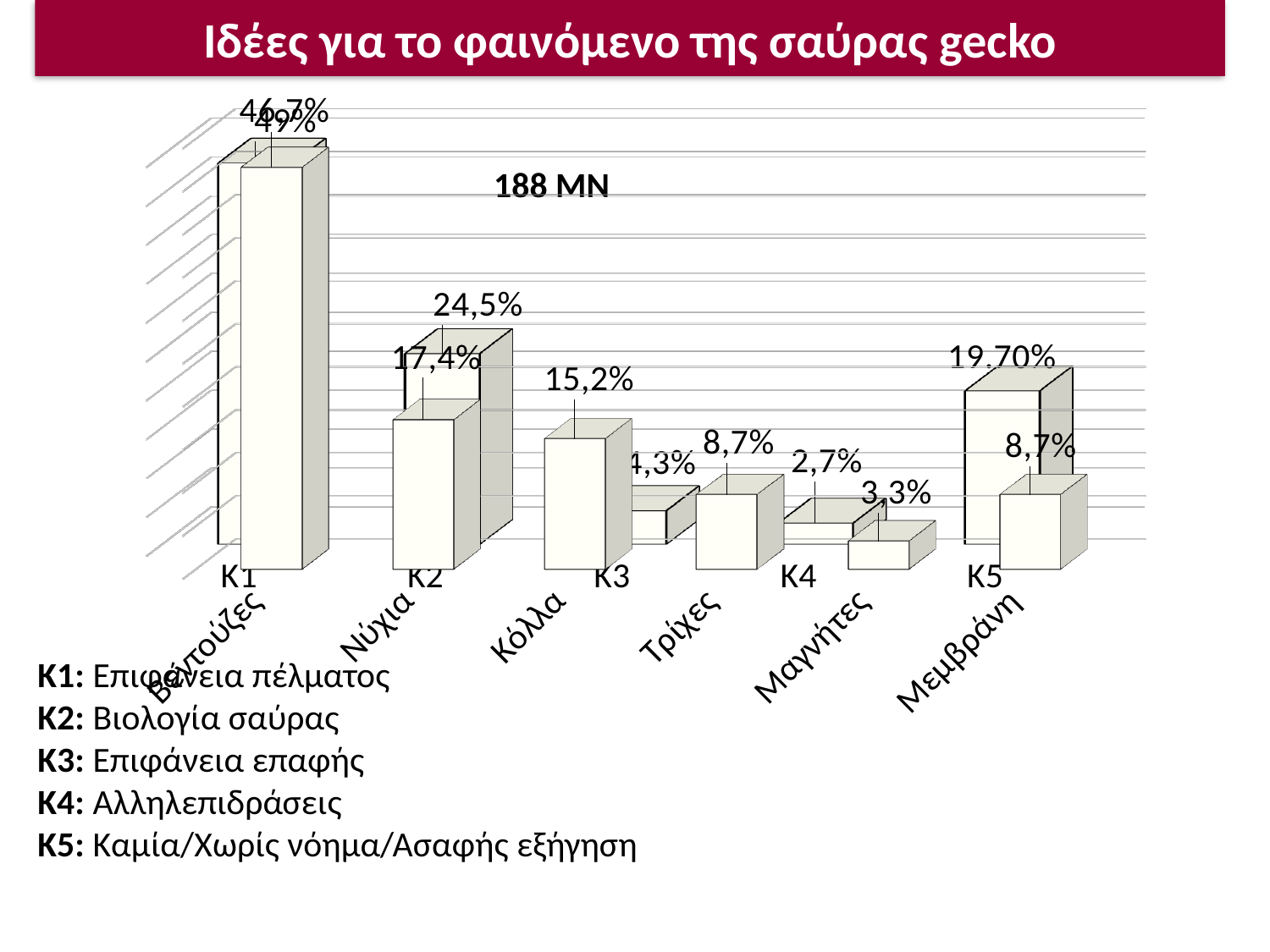
What are the two values labelled for Μαγνήτες? 2,7% and 3,3% What is the title of the slide above the chart? Ιδέες για το φαινόμενο της σαύρας gecko What is the difference between the back bar (24,5%) and the front bar (17,4%) for Νύχια? 7,1% What value is labelled on the back bar for Νύχια? 24,5% What value is labelled on the front bar for Νύχια? 17,4% What value is labelled on the back (taller) bar for Μεμβράνη? 19,70% Which is larger: the front bar for Νύχια (17,4%) or the Κόλλα bar (15,2%)? Νύχια Which category has the lowest values in the chart? Μαγνήτες Which category has the tallest bars in the chart? Βεντούζες What value is labelled on the Κόλλα bar? 15,2% What kind of chart is shown on the slide? bar chart